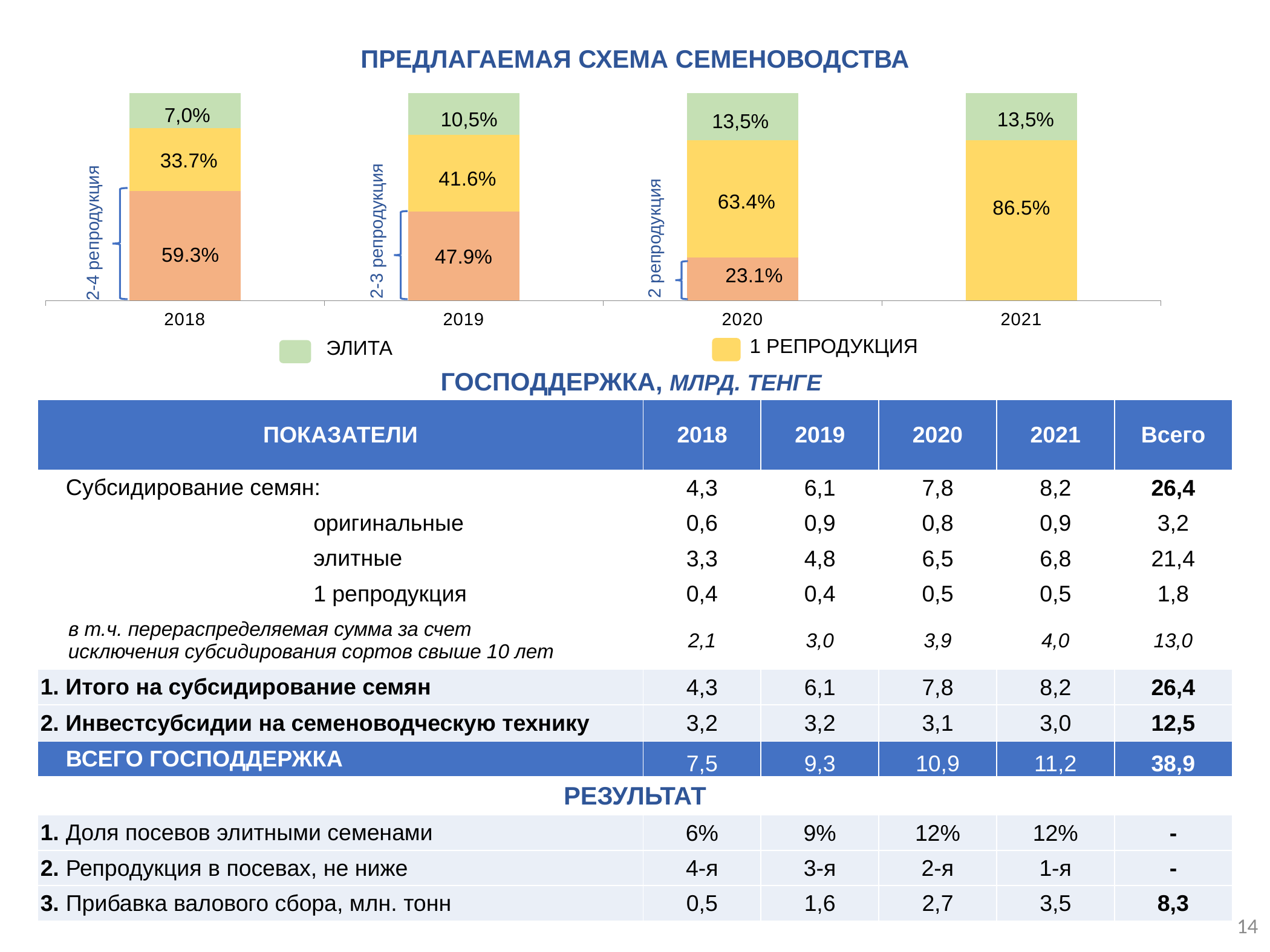
How many series does the chart's legend list? 2 In the chart, which year has the highest 1 РЕПРОДУКЦИЯ share? 2021 In the chart, what is the 1 РЕПРОДУКЦИЯ share for 2021? 86.5% In the chart, what is the 1 РЕПРОДУКЦИЯ share for 2019? 41.6% In the chart, what is the value of the orange (lowest) segment for 2020? 23.1% How many years are shown on the x axis of the chart? 4 In the chart, what is the ЭЛИТА share for 2018? 7,0% Does the 1 РЕПРОДУКЦИЯ share rise or fall from 2018 to 2021 in the chart? Rise In the chart, is the orange segment larger in 2018 or in 2019? 2018 In the chart, which year has the lowest ЭЛИТА share? 2018 In the chart, how much larger is the 1 РЕПРОДУКЦИЯ share in 2020 than in 2019? 21.8 percentage points What type of chart is shown under the title "ПРЕДЛАГАЕМАЯ СХЕМА СЕМЕНОВОДСТВА"? Stacked bar chart